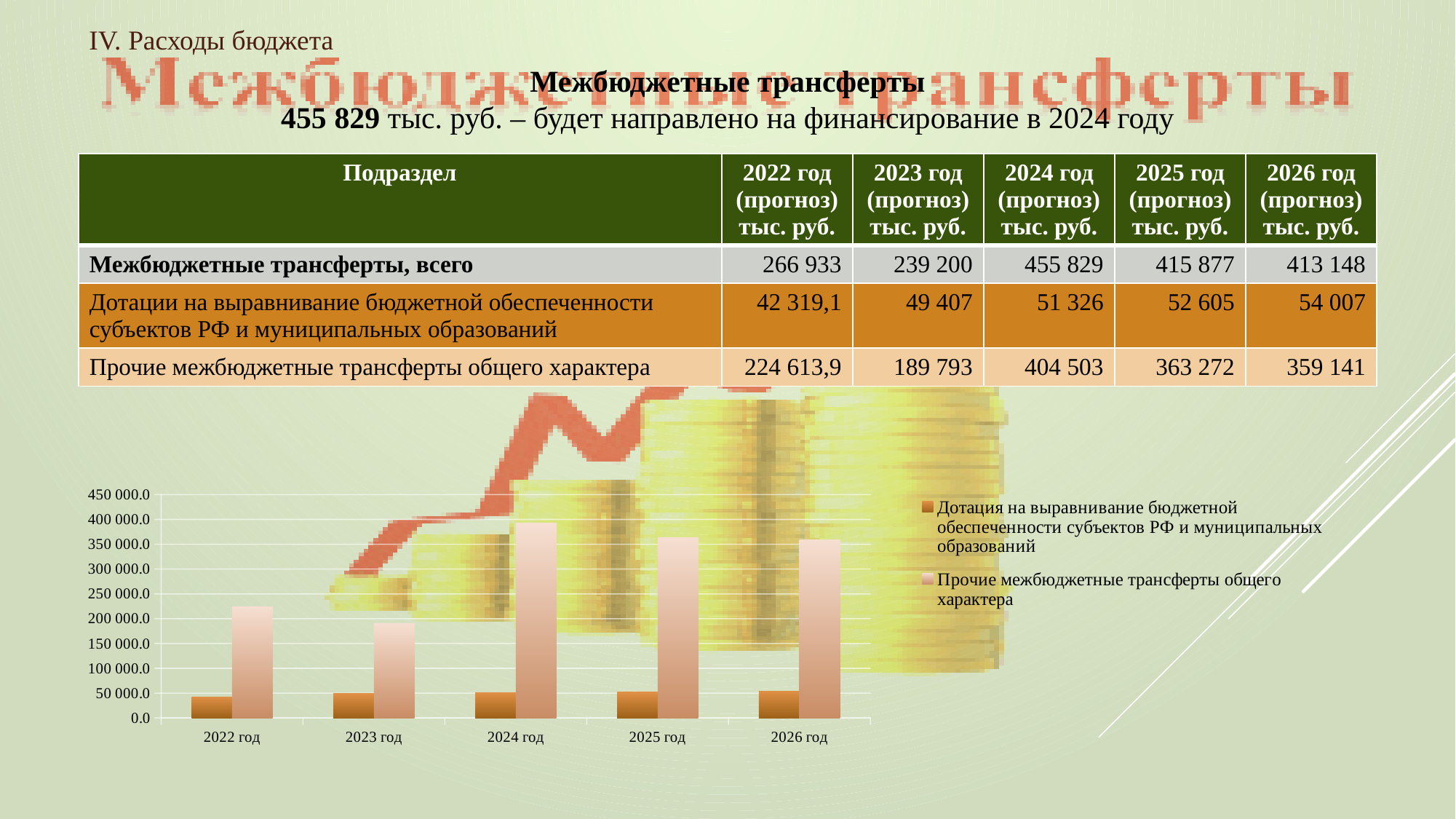
How many years (categories) are shown on the x axis of the bar chart? 5 In the bar chart, which year has the tallest bar for 'Прочие межбюджетные трансферты общего характера'? 2024 год In the bar chart, do the bars for 'Дотация на выравнивание бюджетной обеспеченности' rise or fall from 2022 год to 2026 год? rise How many series does the legend of the bar chart list? 2 What kind of chart is shown at the bottom of the slide? bar chart In the bar chart, is the value for 'Прочие межбюджетные трансферты общего характера' in 2023 год greater or less than 200 000.0? less In the bar chart, is the value for 'Дотация на выравнивание бюджетной обеспеченности' in 2022 год greater or less than 50 000.0? less In the bar chart, which year has the shortest bar for 'Прочие межбюджетные трансферты общего характера'? 2023 год In the bar chart, which year has the larger bar for 'Прочие межбюджетные трансферты общего характера': 2022 год or 2023 год? 2022 год In the bar chart, is the value for 'Прочие межбюджетные трансферты общего характера' in 2024 год greater or less than 350 000.0? greater In the bar chart for 2026 год, which series has the larger bar: 'Дотация на выравнивание бюджетной обеспеченности' or 'Прочие межбюджетные трансферты общего характера'? Прочие межбюджетные трансферты общего характера